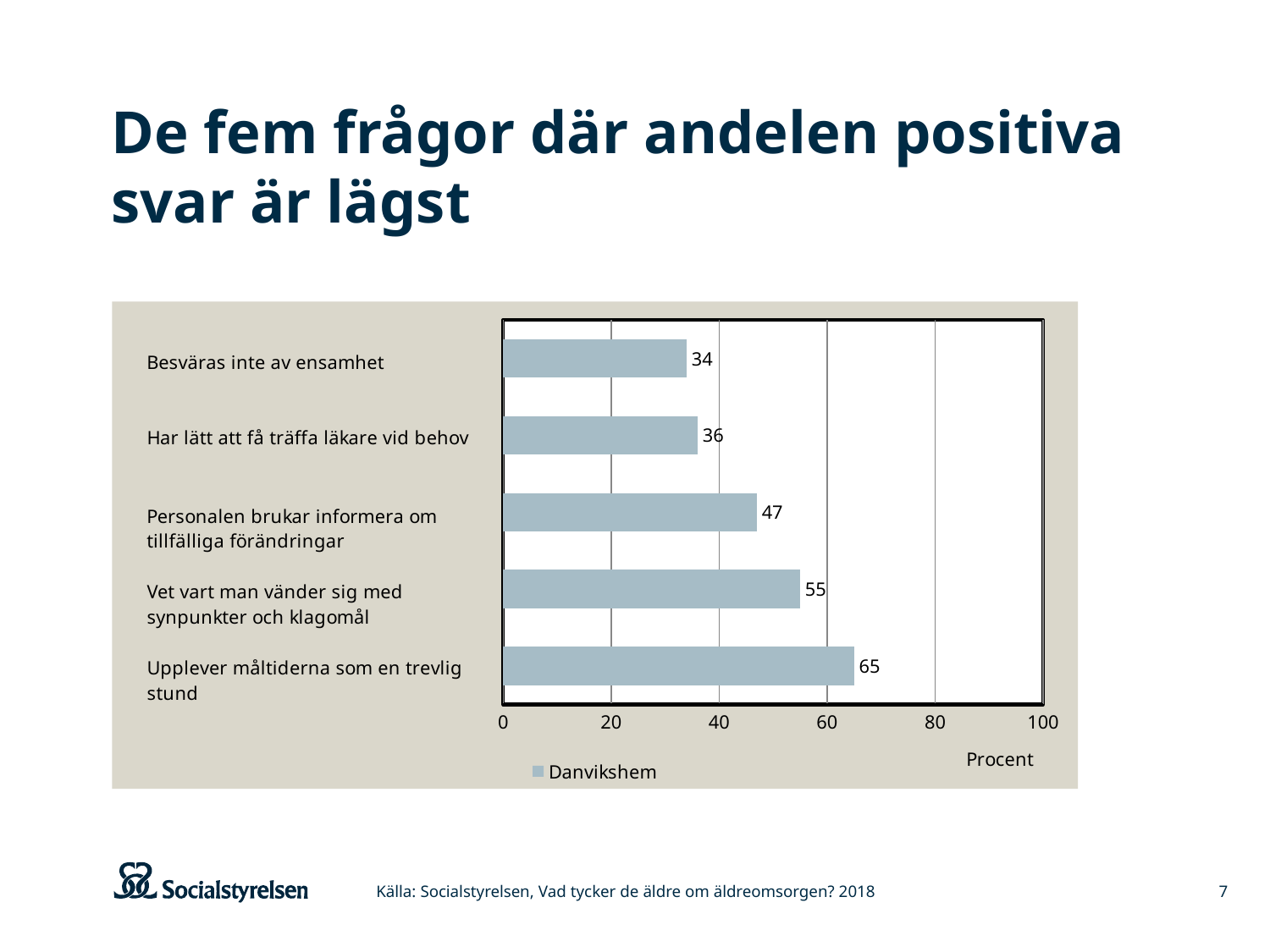
What series name does the legend show? Danvikshem What is the difference between the values for "Upplever måltiderna som en trevlig stund" and "Besväras inte av ensamhet"? 31 What is the value for "Besväras inte av ensamhet"? 34 How many categories are shown in the chart? 5 What is the value for "Upplever måltiderna som en trevlig stund"? 65 Which category has the highest value? Upplever måltiderna som en trevlig stund Is the value for "Vet vart man vänder sig med synpunkter och klagomål" greater or less than 60? less What is the value for "Har lätt att få träffa läkare vid behov"? 36 What kind of chart is shown on the slide? Bar chart Which category has the lowest value? Besväras inte av ensamhet Which is larger: the value for "Vet vart man vänder sig med synpunkter och klagomål" or for "Personalen brukar informera om tillfälliga förändringar"? Vet vart man vänder sig med synpunkter och klagomål What is the value for "Personalen brukar informera om tillfälliga förändringar"? 47